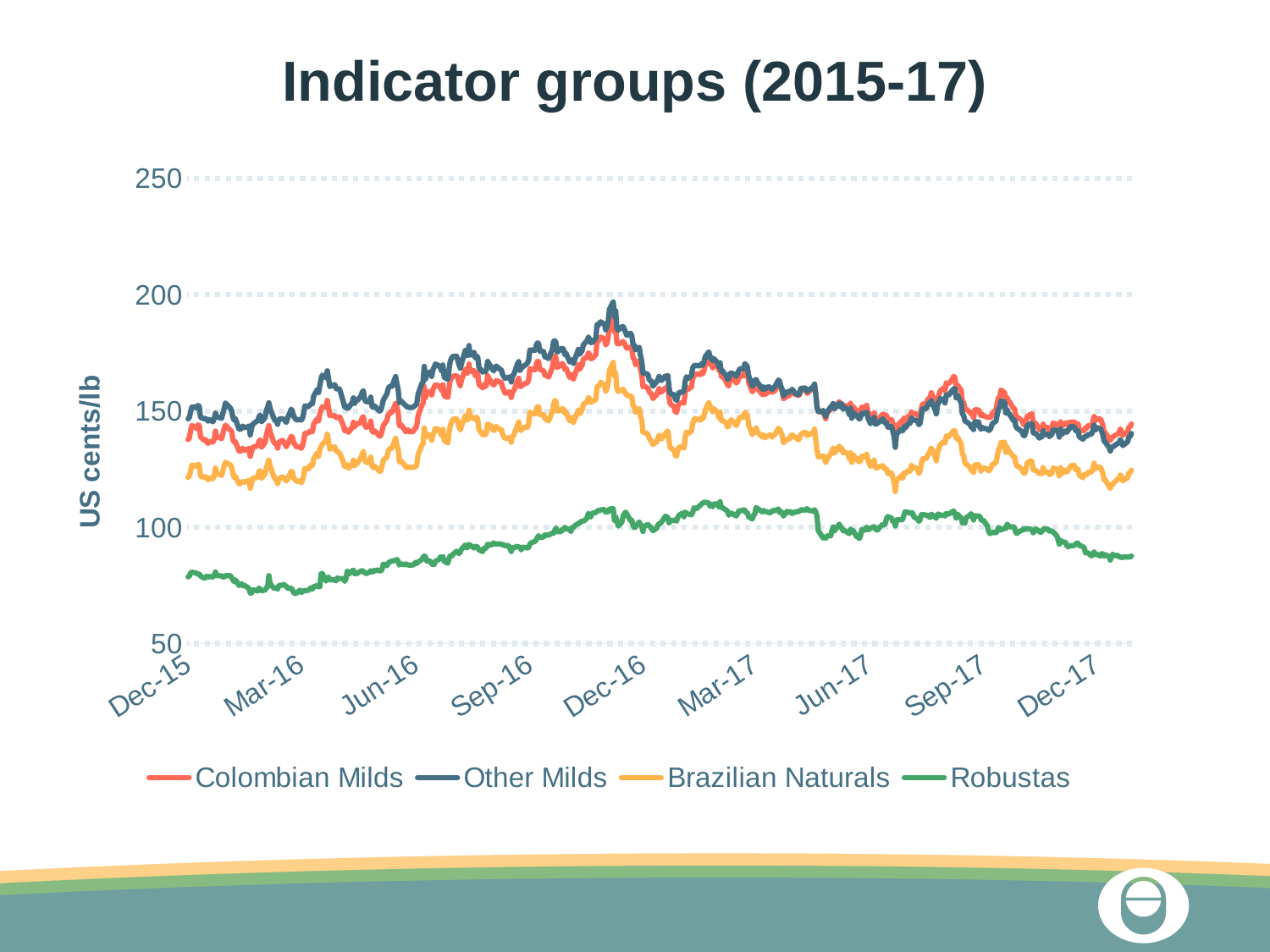
How many series does the legend list? 4 Which series has the lowest values throughout the period shown? Robustas Which is larger at Dec-15, the value for Other Milds or the value for Robustas? Other Milds How many date labels are shown on the horizontal axis? 9 Is the value for Robustas at Mar-17 greater or less than 100? greater Is the peak value for Other Milds around Dec-16 greater or less than 150? greater What is the label on the vertical axis? US cents/lb Does the Robustas line rise or fall between Dec-15 and Dec-16? rise Is the value for Robustas at Dec-15 greater or less than 100? less What is the title of the chart? Indicator groups (2015-17) What kind of chart is shown on the slide? line chart